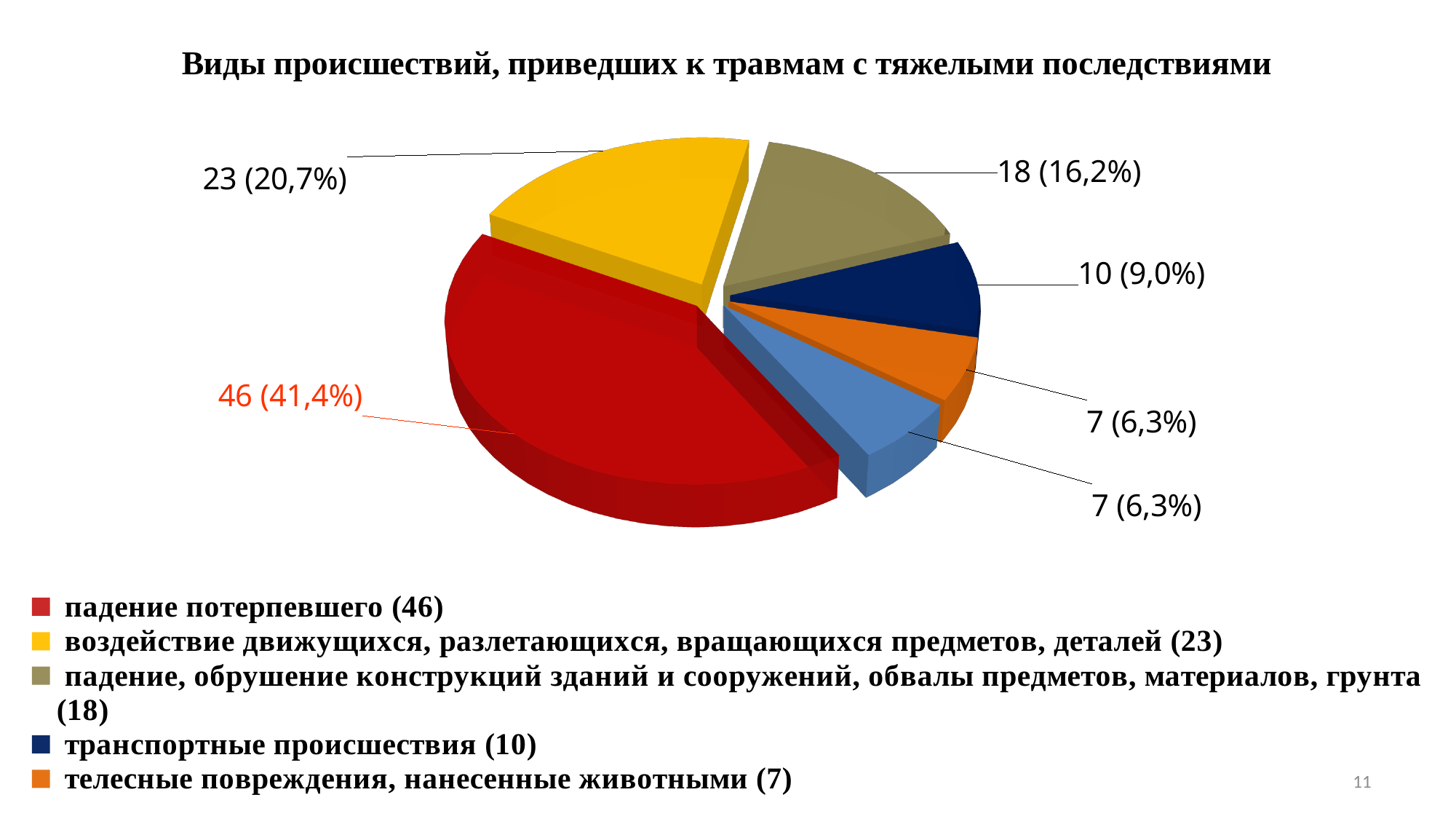
How many cases are shown for "падение потерпевшего"? 46 What is the title of the chart? Виды происшествий, приведших к травмам с тяжелыми последствиями What share of the pie does "транспортные происшествия" take? 9,0% Which is larger: "воздействие движущихся, разлетающихся, вращающихся предметов, деталей" or "падение, обрушение конструкций зданий и сооружений, обвалы предметов, материалов, грунта"? воздействие движущихся, разлетающихся, вращающихся предметов, деталей What share of the pie does "телесные повреждения, нанесенные животными" take? 6,3% What share of the pie does "падение потерпевшего" take? 41,4% What is the difference between the number of cases for "падение потерпевшего" and for "воздействие движущихся, разлетающихся, вращающихся предметов, деталей"? 23 How many slices does the pie chart have? 6 What is the difference between the number of cases for "падение, обрушение конструкций зданий и сооружений, обвалы предметов, материалов, грунта" and for "транспортные происшествия"? 8 Which category has the largest slice of the pie? падение потерпевшего How many cases are shown for "транспортные происшествия"? 10 What kind of chart is shown on the slide? pie chart